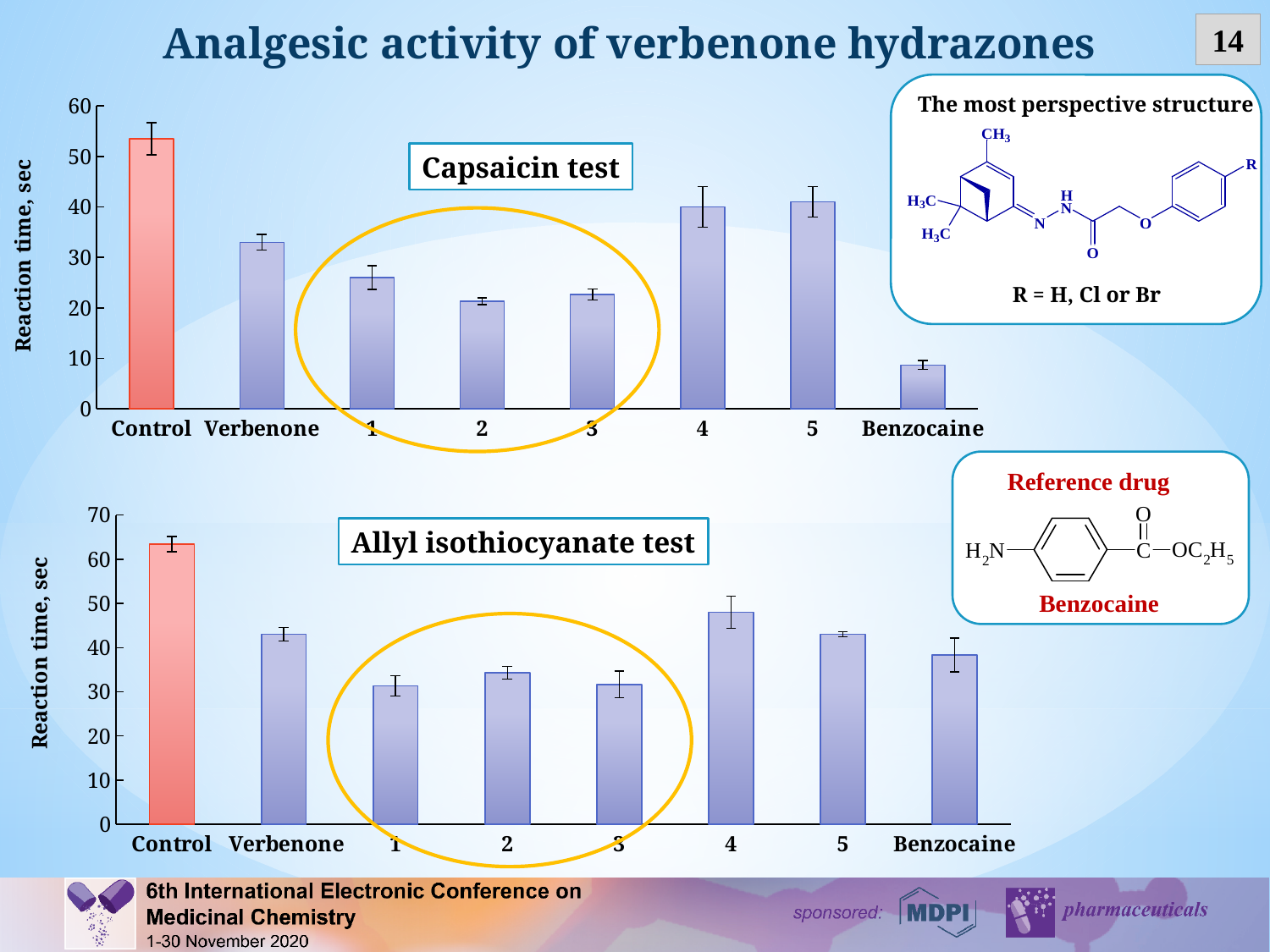
In the Allyl isothiocyanate test chart, is the value for Control greater or less than 60? greater In the Capsaicin test chart, which is larger, the value for compound 2 or the value for compound 4? 4 In the Allyl isothiocyanate test chart, is the value for compound 4 greater or less than 40? greater In the Capsaicin test chart, is the value for Benzocaine greater or less than 10? less In the Allyl isothiocyanate test chart, which category has the highest reaction time? Control In the Capsaicin test chart, which category has the lowest reaction time? Benzocaine What is the y-axis label of the Allyl isothiocyanate test chart? Reaction time, sec In the Capsaicin test chart, which category has the highest reaction time? Control In the Capsaicin test chart, how many categories are shown on the x axis? 8 In the Allyl isothiocyanate test chart, which is larger, the value for Verbenone or the value for compound 1? Verbenone In the Capsaicin test chart, what kind of chart is used? Bar chart